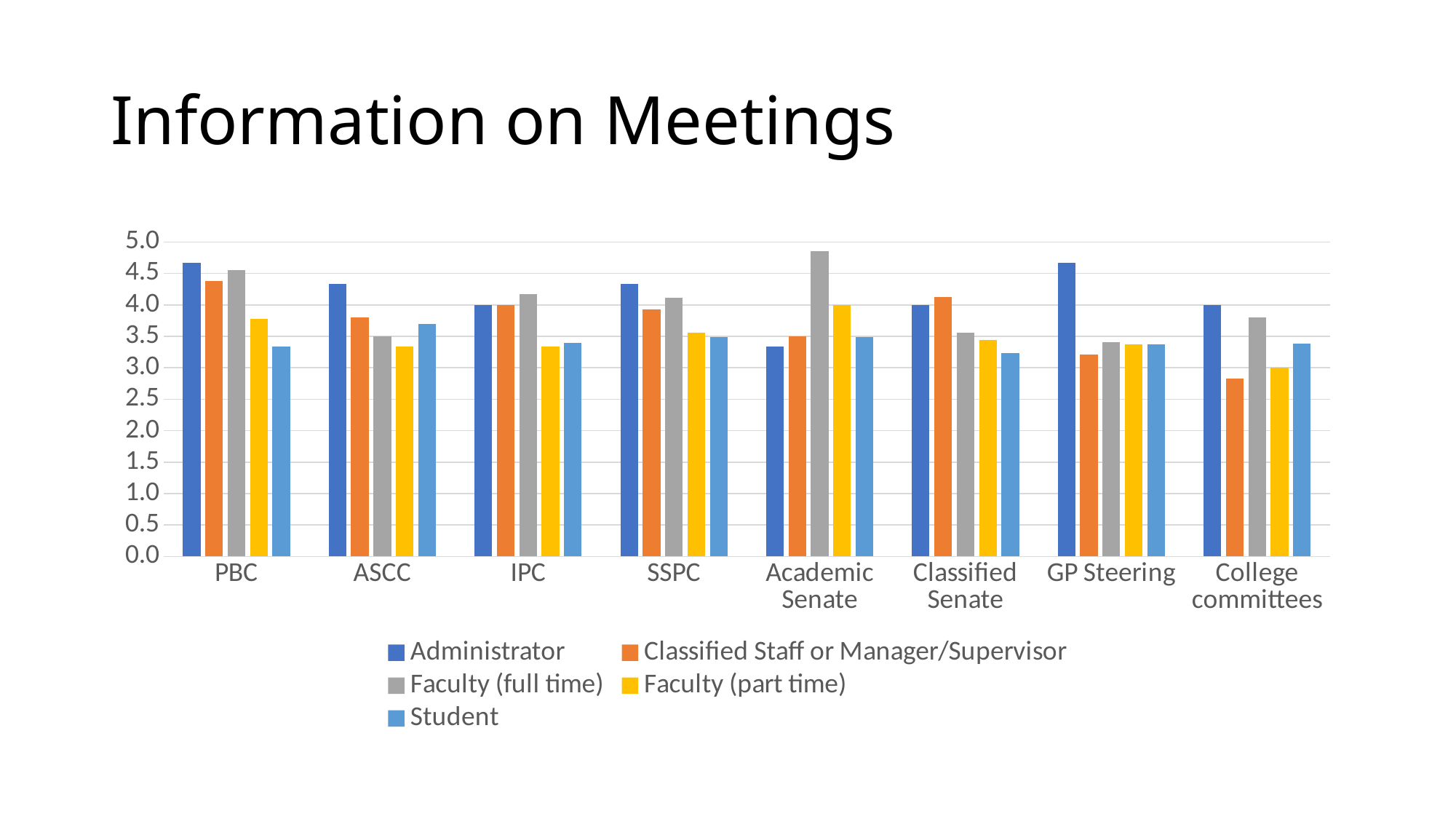
How many categories are shown along the x axis? 8 How many series does the legend list? 5 What type of chart is shown on the slide? bar chart Which category has the highest Faculty (full time) value? Academic Senate For College committees, which series has the lowest bar? Classified Staff or Manager/Supervisor Is the Student value for PBC greater or less than 3.5? less What is the title of the chart? Information on Meetings For Academic Senate, which series has the highest bar? Faculty (full time) Is the Administrator value for GP Steering greater or less than 4.5? greater For PBC, which is larger: the Administrator value or the Student value? Administrator What is the Administrator value for IPC? 4.0 Is the Classified Staff or Manager/Supervisor value for College committees greater or less than 3.0? less